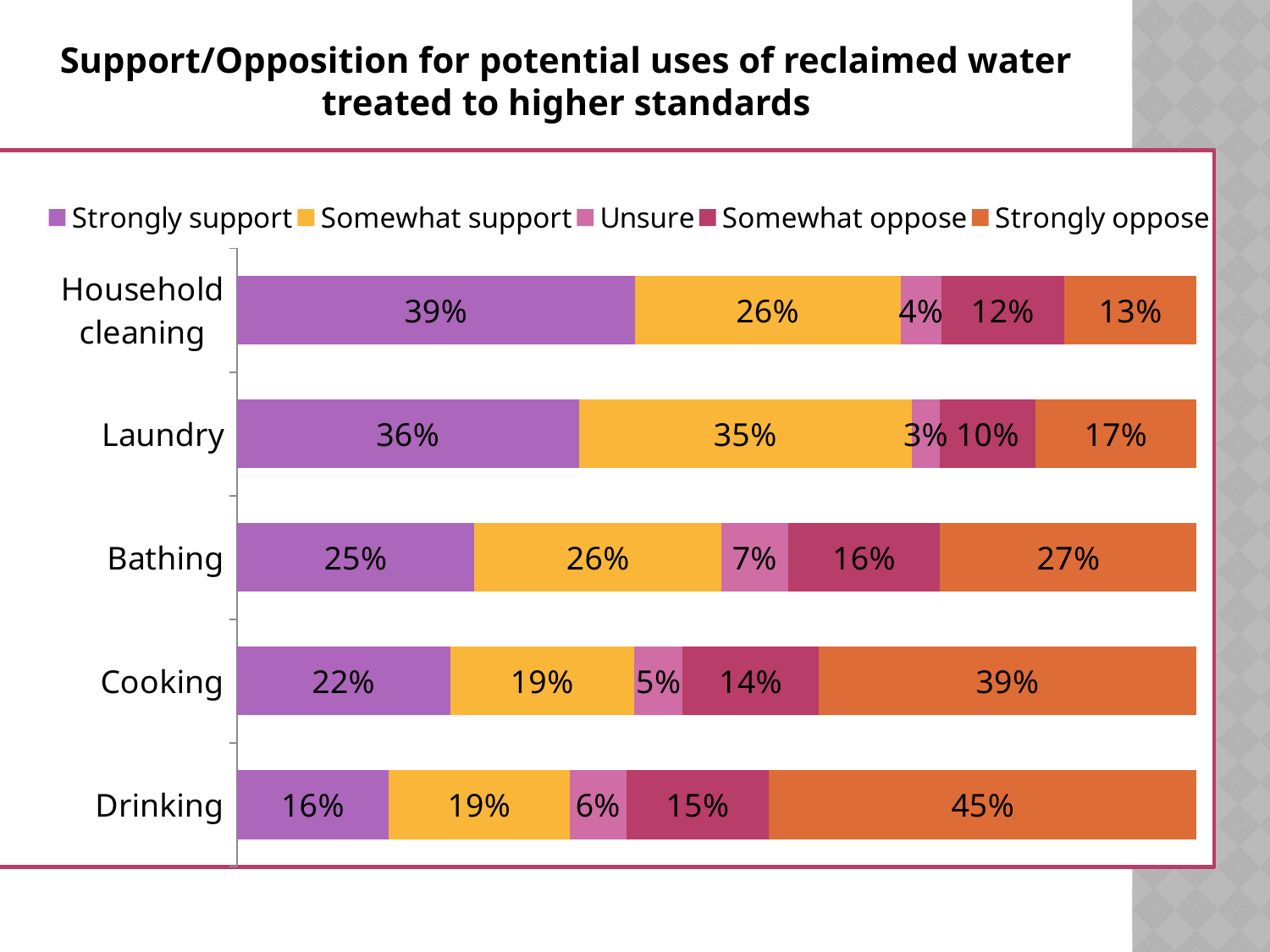
What percentage strongly oppose using reclaimed water for drinking? 45% Which is larger: the Somewhat oppose percentage for Bathing or for Laundry? Bathing What percentage are unsure about using reclaimed water for bathing? 7% Which use has the lowest Strongly support percentage? Drinking What is the difference between the Strongly oppose percentages for Cooking and Household cleaning? 26% What percentage strongly support using reclaimed water for household cleaning? 39% Which use has the highest Strongly oppose percentage? Drinking What kind of chart is shown on the slide? Stacked bar chart What percentage somewhat support using reclaimed water for laundry? 35% What is the combined Strongly support and Somewhat support percentage for Laundry? 71% How many series does the legend list? 5 How many uses of reclaimed water are shown on the chart? 5